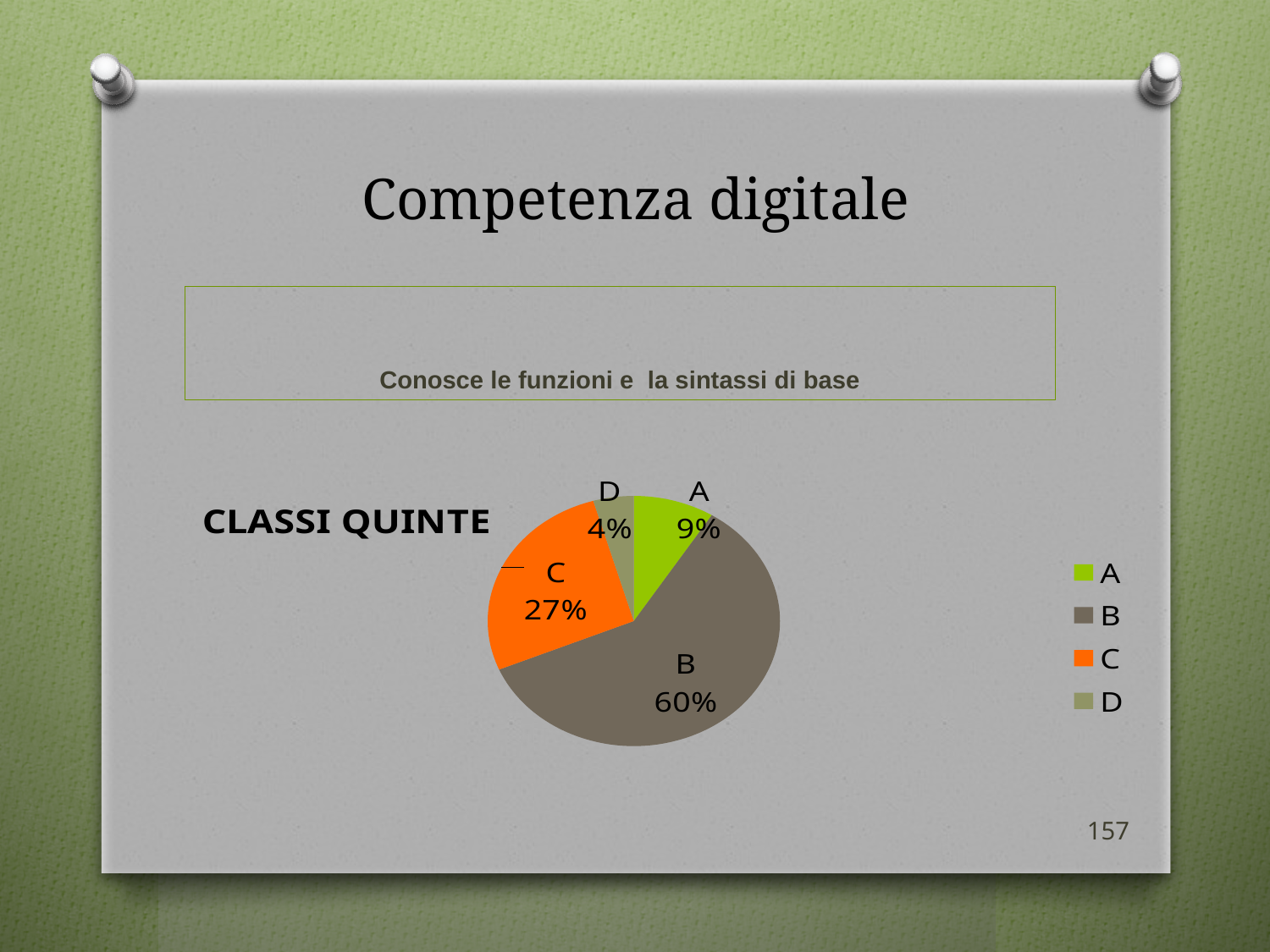
What is the difference between the values for B and C in the pie chart? 33% What is the value shown for slice A in the pie chart? 9% What share of the pie chart does slice B represent? 60% Which is larger in the pie chart, slice A or slice C? C How many entries does the legend of the pie chart list? 4 How many slices does the pie chart have? 4 What colour is slice C in the pie chart? Orange Which slice of the pie chart is the smallest? D What is the value shown for slice D in the pie chart? 4% What is the value shown for slice C in the pie chart? 27% Which slice of the pie chart is the largest? B What kind of chart is shown on the slide? Pie chart